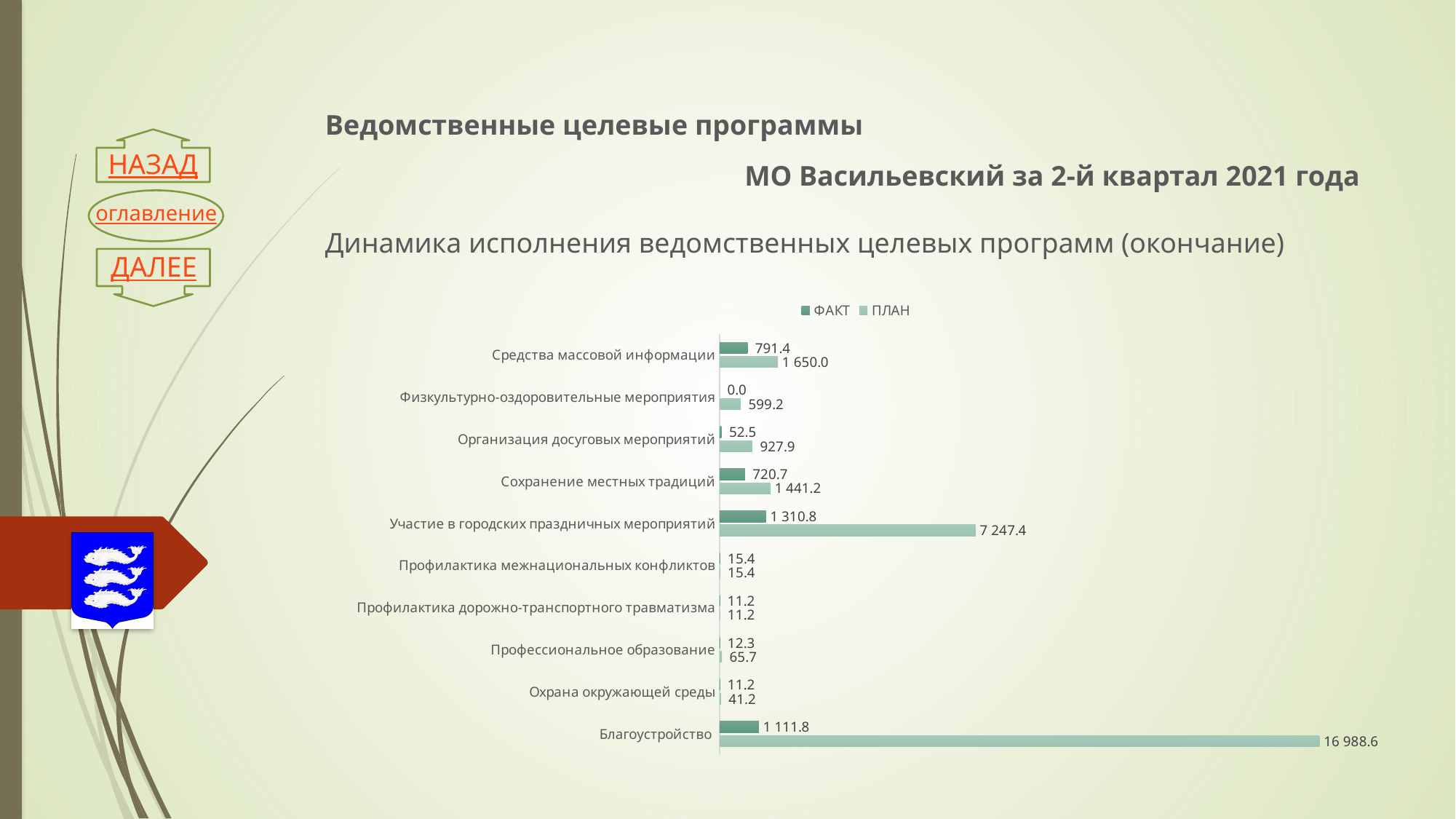
What are the two series named in the legend? ФАКТ and ПЛАН Which category has the lowest ФАКТ value? Физкультурно-оздоровительные мероприятия What is the ФАКТ value for Средства массовой информации? 791.4 What is the ПЛАН value for Благоустройство? 16 988.6 What is the ФАКТ value for Физкультурно-оздоровительные мероприятия? 0.0 Which is larger, the ФАКТ value for Средства массовой информации or the ФАКТ value for Сохранение местных традиций? Средства массовой информации What is the difference between the ПЛАН and ФАКТ values for Сохранение местных традиций? 720.5 What is the ПЛАН value for Участие в городских праздничных мероприятий? 7 247.4 How many categories are shown in the chart? 10 How many series does the legend list? 2 What kind of chart is shown on the slide? Bar chart Which category has the highest ПЛАН value? Благоустройство